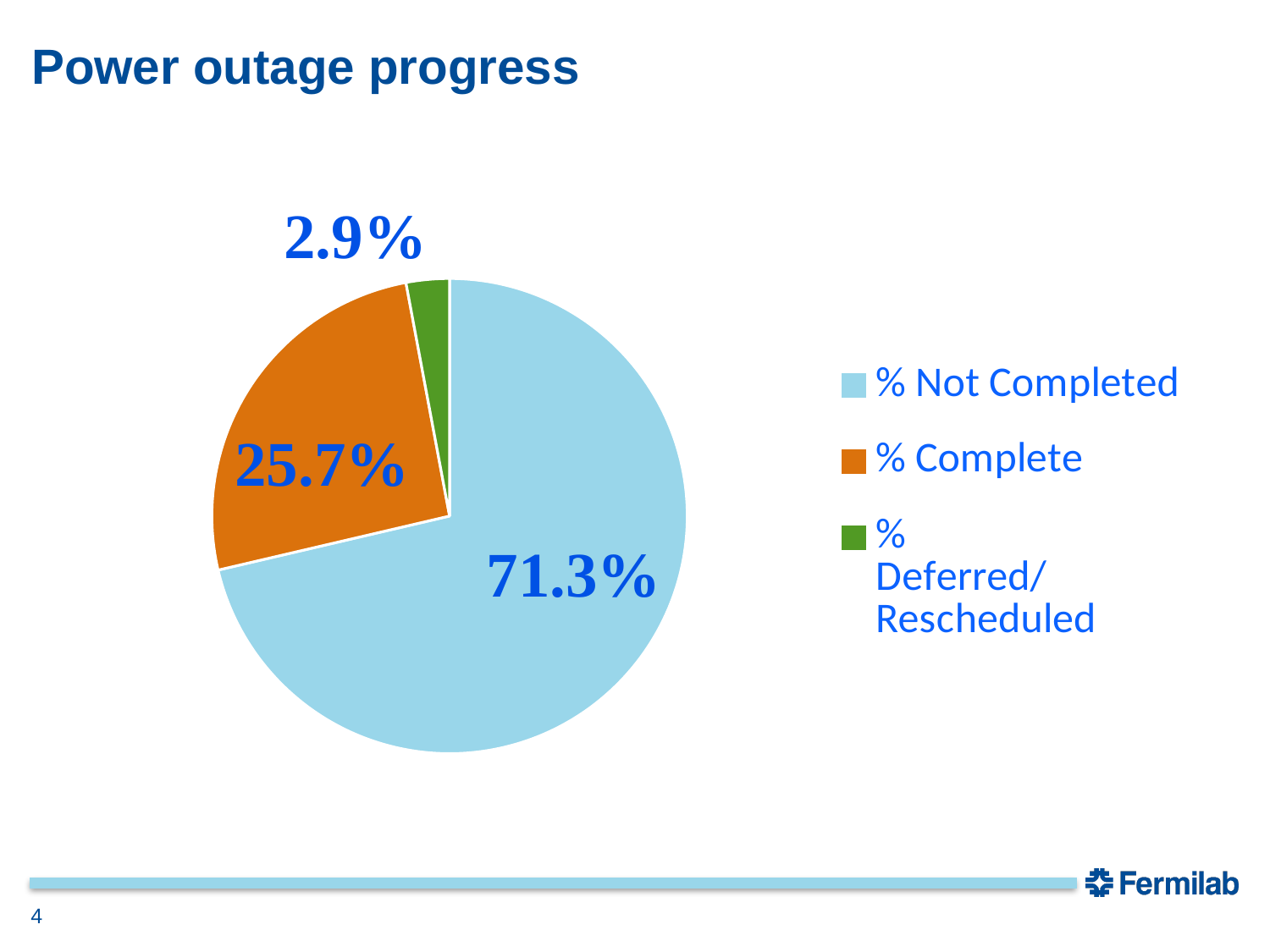
What is the value for % Not Completed? 71.3% What is the value for % Deferred/Rescheduled? 2.9% What kind of chart is shown on the slide? pie chart Which slice is the largest? % Not Completed Which is larger, % Complete or % Deferred/Rescheduled? % Complete What colour is the % Complete slice? orange Which slice is the smallest? % Deferred/Rescheduled What is the difference between % Complete and % Deferred/Rescheduled? 22.8% What is the value for % Complete? 25.7% What is the difference between % Not Completed and % Complete? 45.6% How many slices does the pie chart have? 3 What is the title of the slide containing the chart? Power outage progress